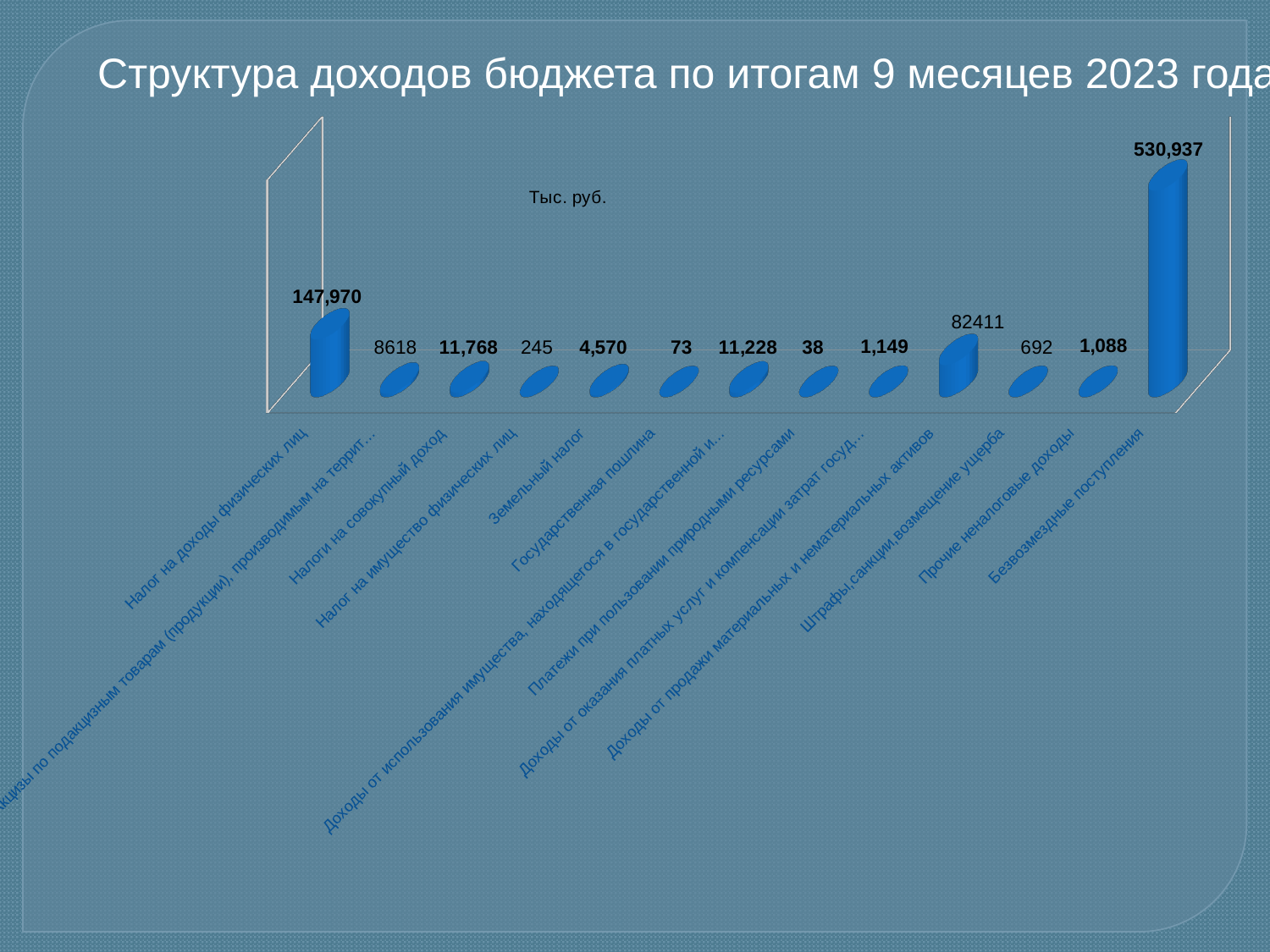
What is the value for Земельный налог? 4,570 What unit is indicated on the chart? Тыс. руб. How many categories are plotted in the chart? 13 What is the difference between the values for Безвозмездные поступления and Налог на доходы физических лиц? 382,967 What is the value for Налог на доходы физических лиц? 147,970 What is the value for Безвозмездные поступления? 530,937 What type of chart is shown on the slide? bar chart Which is larger: the value for Налоги на совокупный доход or the value for Прочие неналоговые доходы? Налоги на совокупный доход What is the value for Доходы от продажи материальных и нематериальных активов? 82411 What is the value for Государственная пошлина? 73 Which category has the highest value? Безвозмездные поступления Which category has the lowest value? Платежи при пользовании природными ресурсами